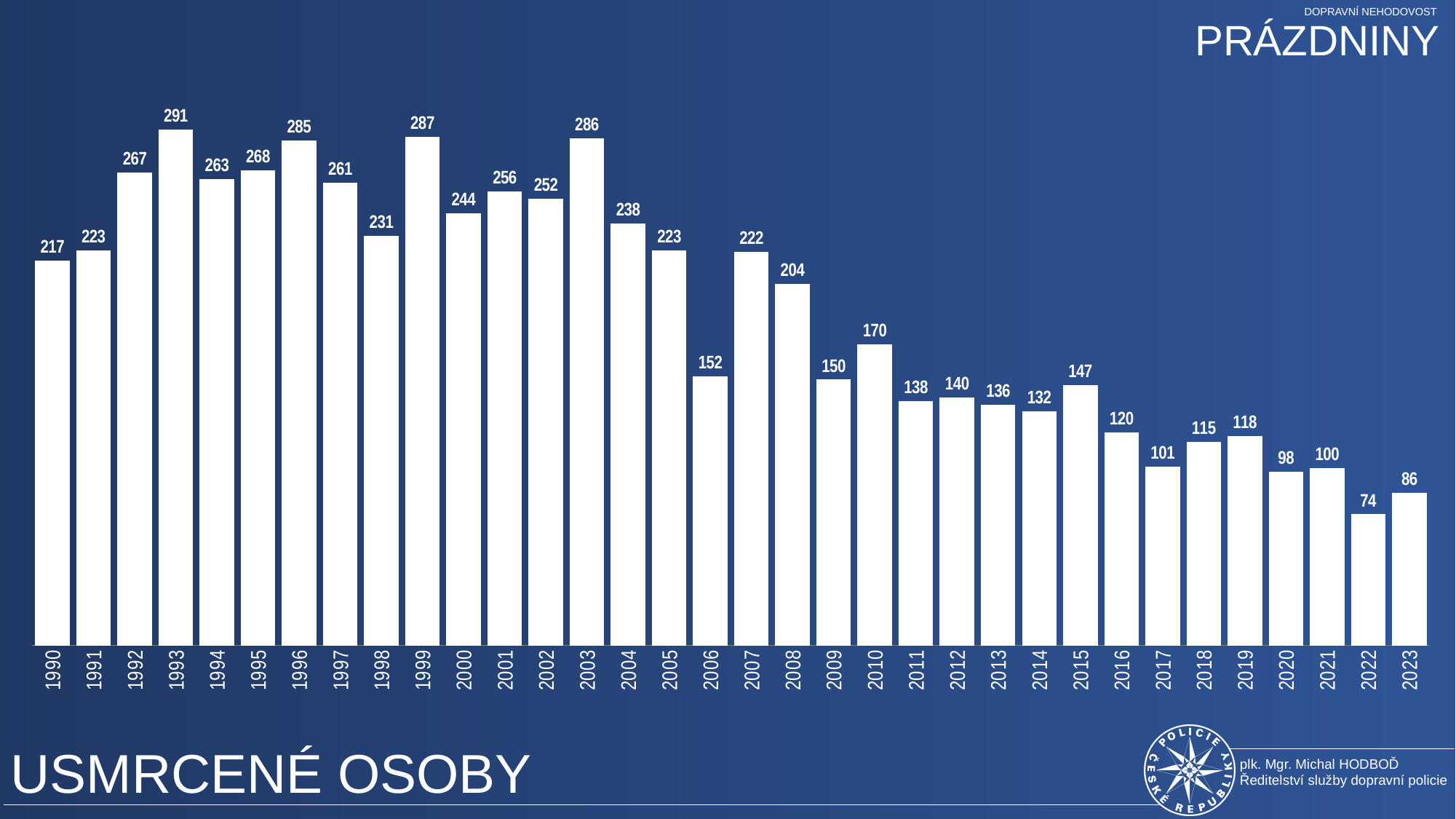
How many years are shown on the x axis? 34 What is the difference between the values for 2003 and 2004? 48 Which is larger, the value for 2015 or the value for 2016? 2015 What is the value for 2023? 86 Do the values generally rise or fall from 2003 to 2023? fall What kind of chart is shown on the slide? bar chart What is the value for 2010? 170 What is the value for 1993? 291 Which is larger, the value for 1999 or the value for 2003? 1999 Which year has the highest value? 1993 What is the difference between the values for 1990 and 2023? 131 Which year has the lowest value? 2022